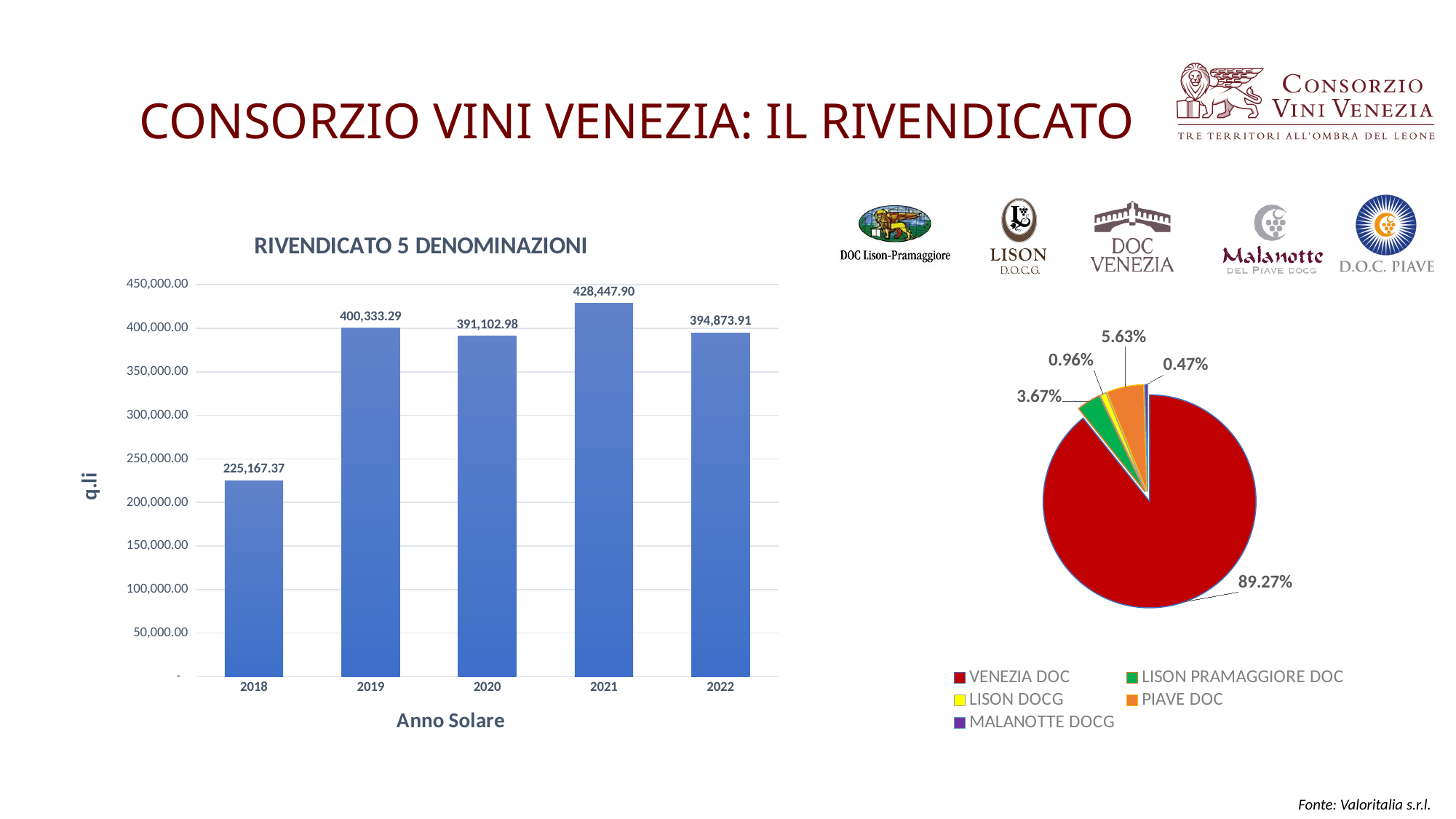
In the pie chart on the right, what share does VENEZIA DOC have? 89.27% In the bar chart 'RIVENDICATO 5 DENOMINAZIONI', what is the label of the y axis? q.li In the bar chart 'RIVENDICATO 5 DENOMINAZIONI', what is the value for 2018? 225,167.37 What kind of chart is 'RIVENDICATO 5 DENOMINAZIONI'? bar chart In the bar chart 'RIVENDICATO 5 DENOMINAZIONI', which is larger, the value for 2019 or the value for 2020? 2019 In the pie chart on the right, what share does PIAVE DOC have? 5.63% In the bar chart 'RIVENDICATO 5 DENOMINAZIONI', how many years are shown on the x axis? 5 In the bar chart 'RIVENDICATO 5 DENOMINAZIONI', what is the value for 2021? 428,447.90 In the bar chart 'RIVENDICATO 5 DENOMINAZIONI', which year has the highest value? 2021 In the bar chart 'RIVENDICATO 5 DENOMINAZIONI', which year has the lowest value? 2018 In the bar chart 'RIVENDICATO 5 DENOMINAZIONI', what is the difference between the 2021 and 2018 values? 203,280.53 How many entries does the legend of the pie chart on the right list? 5